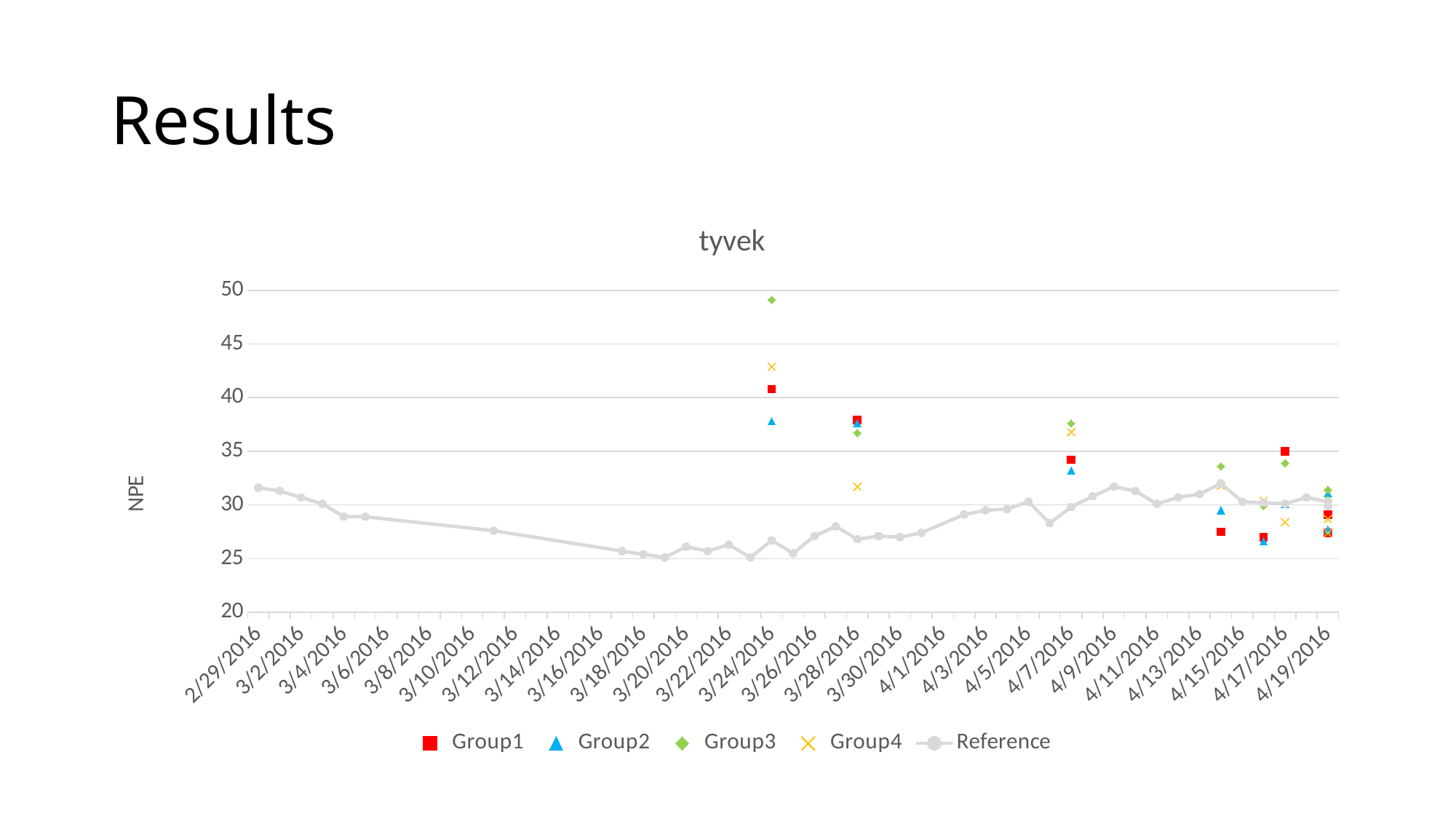
Is the Group4 value on 3/28/2016 greater or less than 35? less Does the Reference line rise or fall from 2/29/2016 to 3/20/2016? fall Which series has the highest value on 3/24/2016? Group3 Which series has the lowest value on 3/24/2016? Reference On 4/7/2016, which is higher, Group3 or Group2? Group3 Is the Group3 value on 3/24/2016 greater or less than 45? greater Is the Reference value on 3/20/2016 greater or less than 30? less What is the label on the vertical axis of the chart? NPE How many series does the chart legend list? 5 Which series has the lowest value on 3/28/2016? Reference What is the title of the chart? tyvek